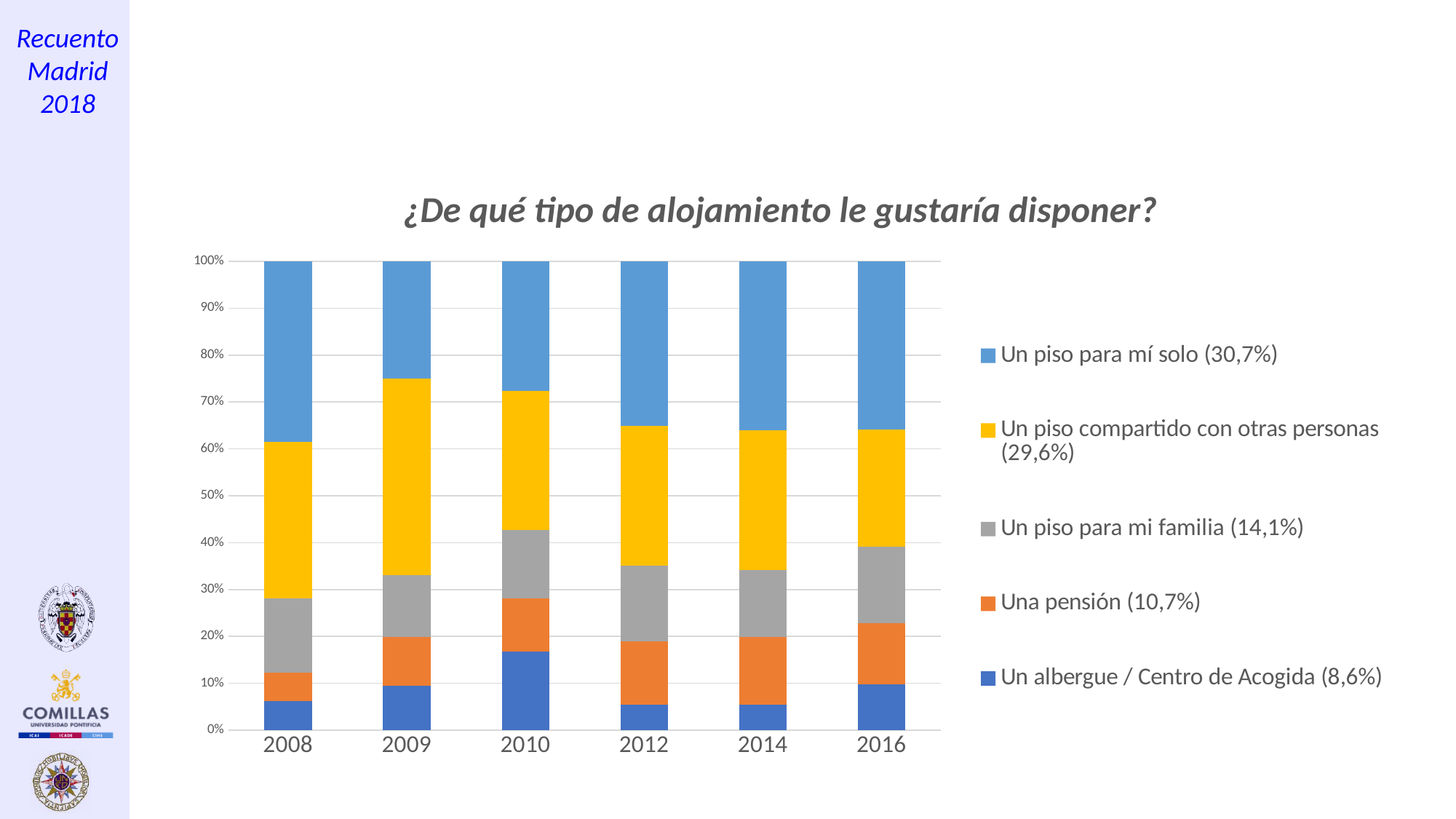
Is the value for 'Un piso para mí solo' in 2009 greater or less than 30%? less Is the value for 'Un albergue / Centro de Acogida' in 2010 greater or less than 10%? greater How many series does the legend list? 5 How many years are shown on the x axis of the chart? 6 Which is larger: the 'Un albergue / Centro de Acogida' segment in 2010 or in 2008? 2010 In which year is the 'Un albergue / Centro de Acogida' segment the largest? 2010 Is the value for 'Un albergue / Centro de Acogida' in 2008 greater or less than 10%? less What kind of chart is shown on the slide? Stacked bar chart In which year is the 'Una pensión' segment the smallest? 2008 What percentage is shown in the legend next to 'Una pensión'? 10,7% What is the title of the chart? ¿De qué tipo de alojamiento le gustaría disponer? In which year is the 'Un piso compartido con otras personas' segment the largest? 2009